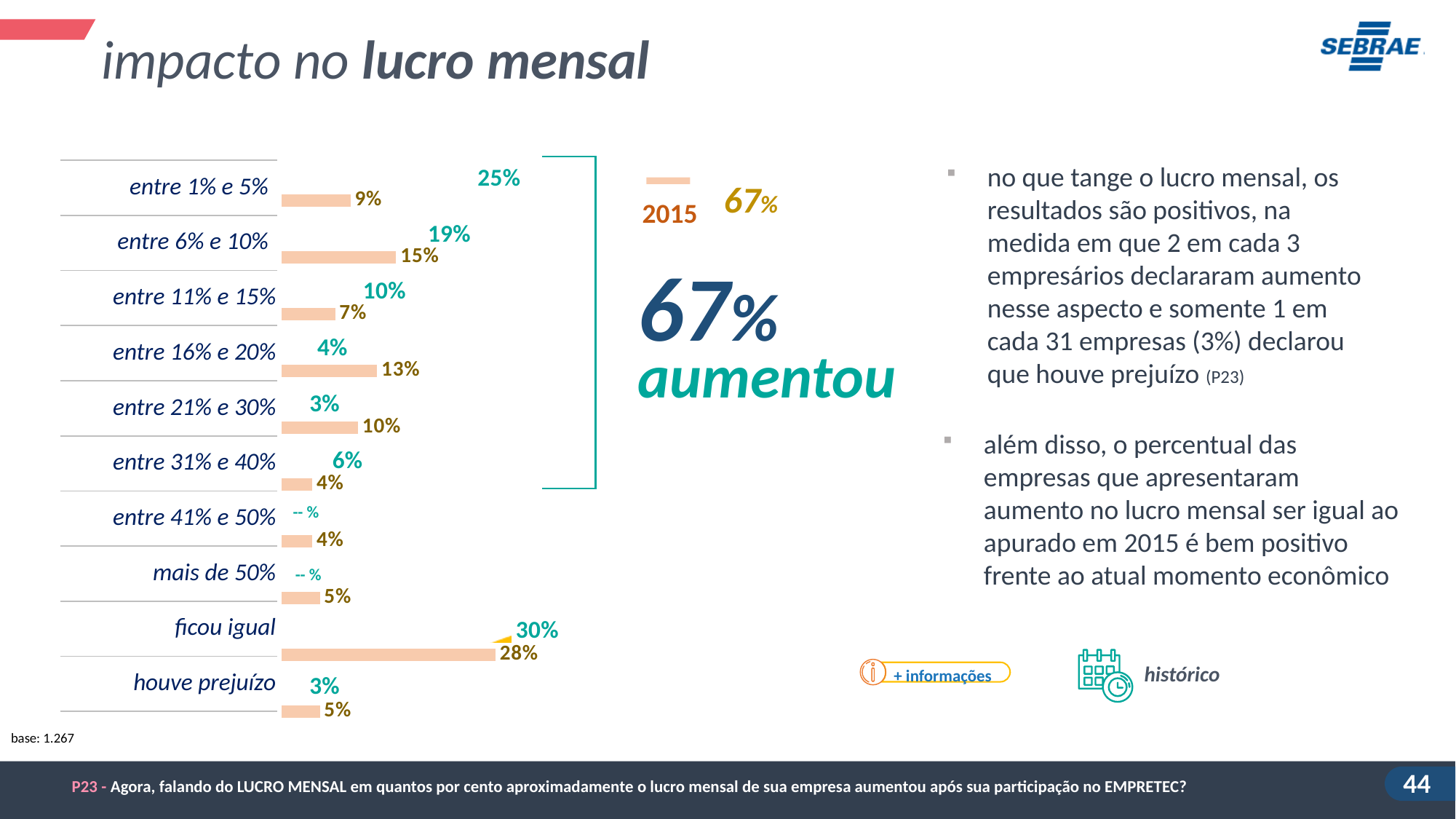
What is the teal-labelled (current) value for the category "entre 6% e 10%"? 19% Which category has the highest 2015 value? ficou igual What is the teal-labelled (current) value for the category "entre 1% e 5%"? 25% Which category has the highest teal-labelled (current) value? ficou igual For the category "entre 16% e 20%", which is larger: the 2015 value or the teal-labelled (current) value? The 2015 value What is the difference between the teal-labelled (current) value and the 2015 value for "entre 1% e 5%"? 16 percentage points Which year does the peach-coloured bar series in the legend represent? 2015 What is the 2015 value for the category "houve prejuízo"? 5% What is the 2015 value for the category "ficou igual"? 28% What is the difference between the teal-labelled (current) value and the 2015 value for "ficou igual"? 2 percentage points What kind of chart is shown on the slide? Bar chart How many categories are shown in the chart? 10